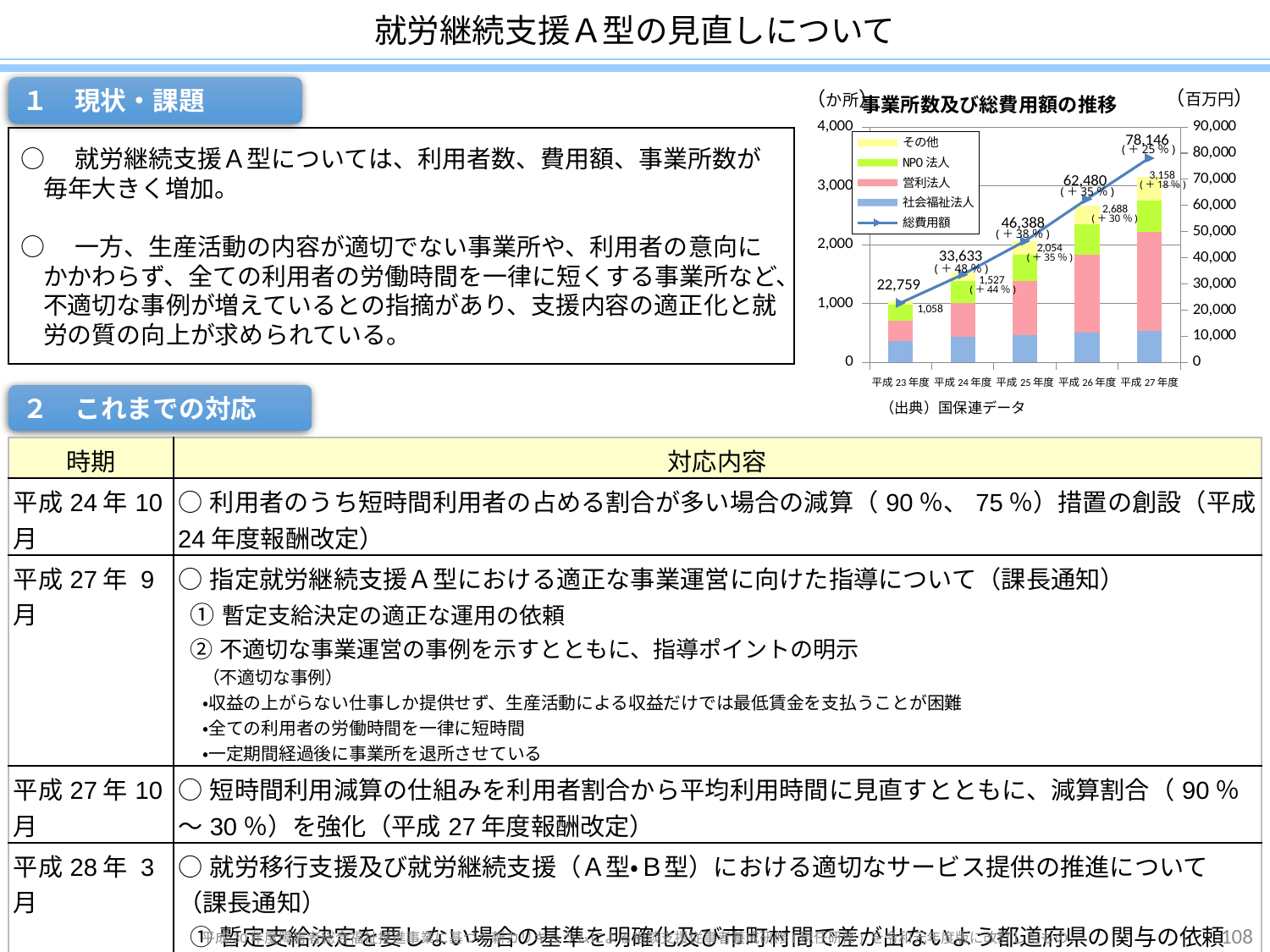
Which fiscal year has the highest 総費用額? 平成27年度 What is the total number of 事業所 for 平成24年度? 1,527 By how much did 総費用額 increase from 平成26年度 to 平成27年度? 15,666 What is the value of 総費用額 for 平成23年度? 22,759 Which fiscal year has the lowest total number of 事業所? 平成23年度 What is the total number of 事業所 (top of the stacked bar) for 平成25年度? 2,054 Does 総費用額 rise or fall from 平成23年度 to 平成27年度? rise What is the title of the chart on the slide? 事業所数及び総費用額の推移 What is the difference in the total number of 事業所 between 平成27年度 and 平成26年度? 470 How many entries does the chart's legend list? 5 How many fiscal years are shown on the x axis of the chart? 5 What is the value of 総費用額 for 平成27年度? 78,146